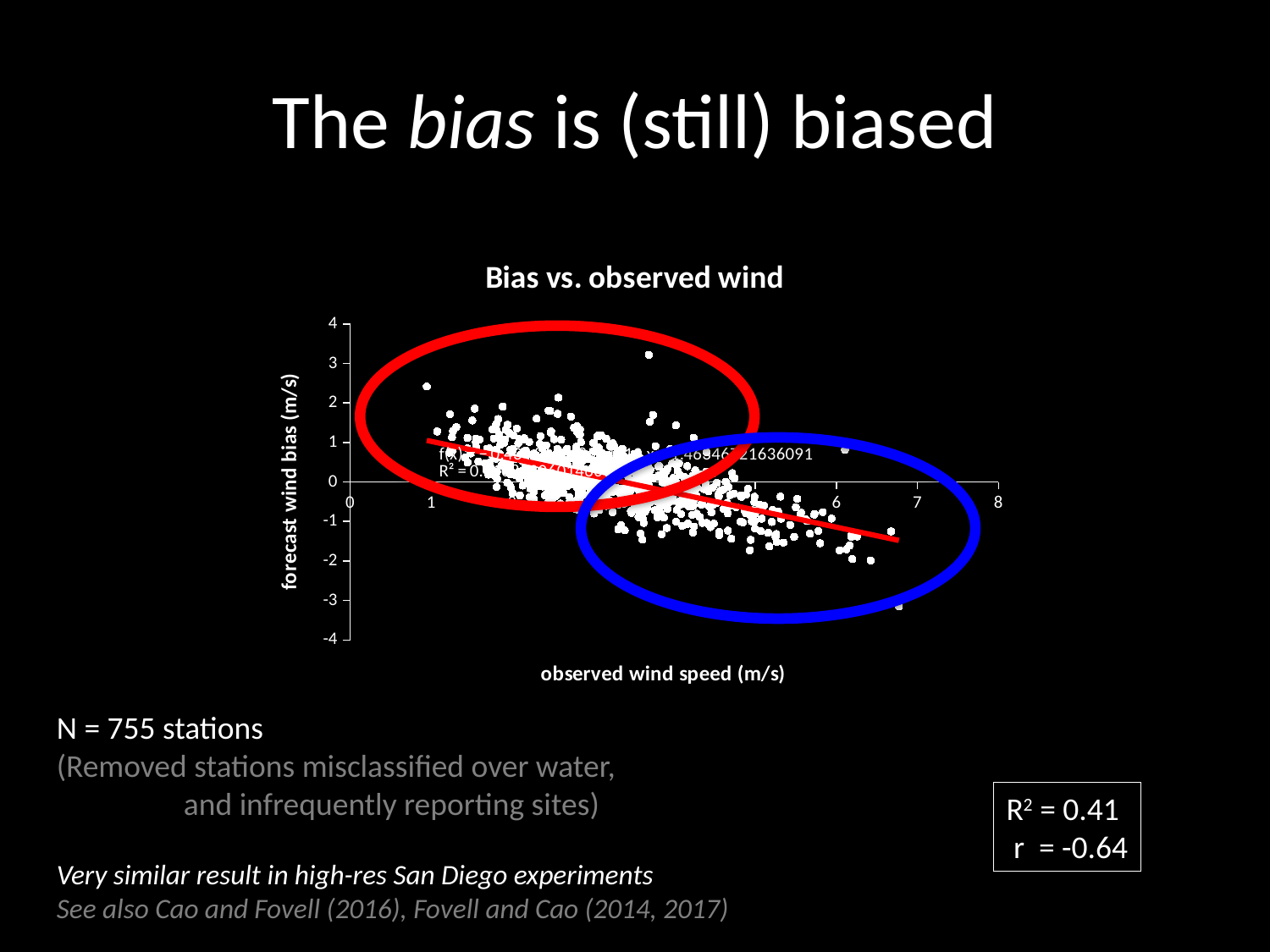
Is the correlation between observed wind speed and forecast wind bias positive or negative? negative What is the label of the x axis of the chart? observed wind speed (m/s) What kind of chart is shown on the slide? scatter plot As observed wind speed increases along the x axis, does the forecast wind bias generally rise or fall? fall Is the fitted trend line's value at an observed wind speed of 1 m/s greater or less than 0? greater What R² value is reported for the relationship shown in the chart? 0.41 What is the title of the chart? Bias vs. observed wind How many stations (N) are plotted in the chart according to the slide? 755 Is the fitted trend line's value at an observed wind speed of 6 m/s greater or less than 0? less What correlation coefficient r is reported for the relationship shown in the chart? -0.64